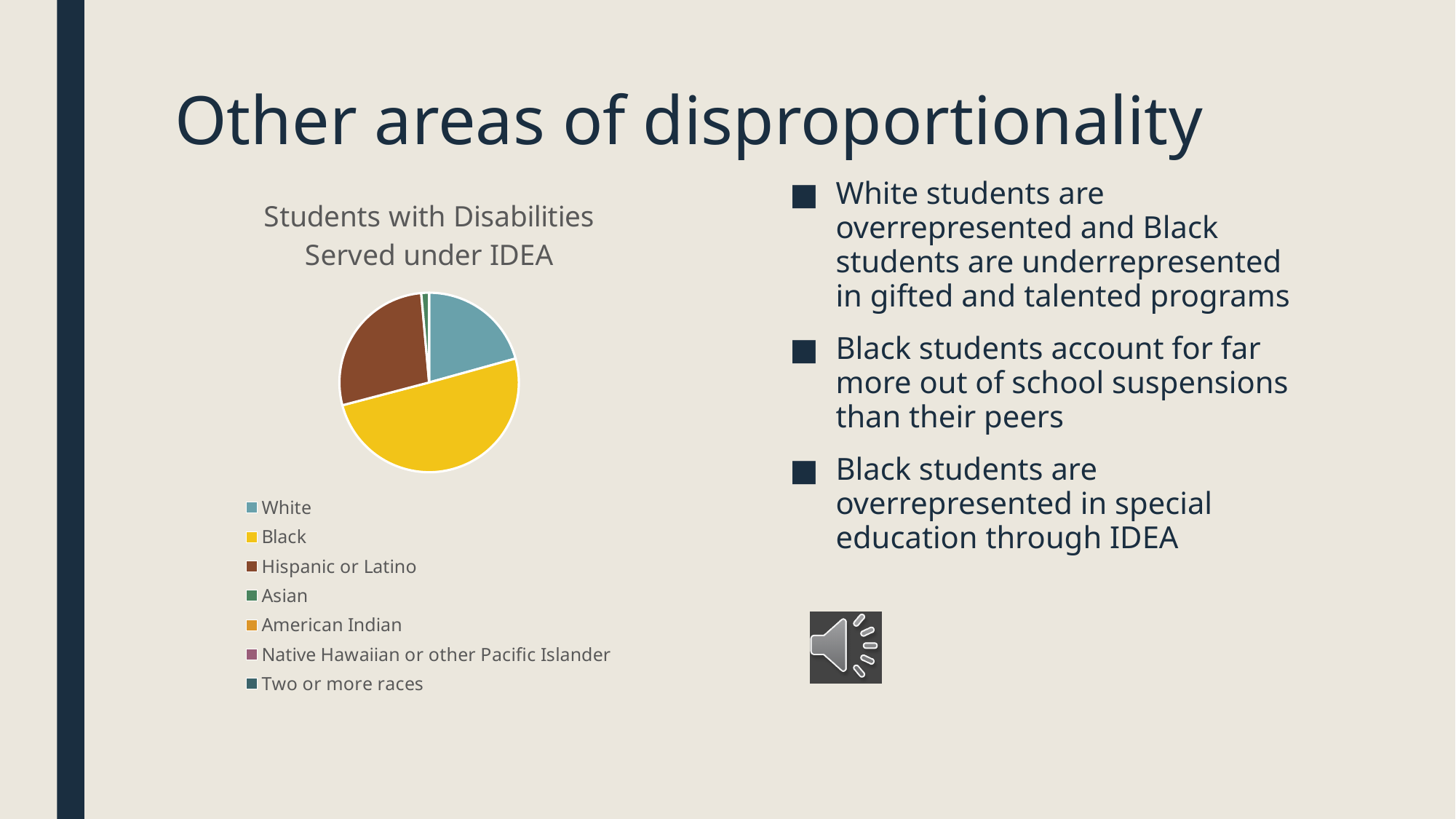
Which category has the largest slice of the pie? Black Which slice is larger, Black or White? Black What kind of chart is shown on the slide? Pie chart What colour is the Black slice in the pie chart? Yellow Which slice is larger, Hispanic or Latino or White? Hispanic or Latino Which slice is larger, Black or Hispanic or Latino? Black What is the title of the chart? Students with Disabilities Served under IDEA How many categories does the chart's legend list? 7